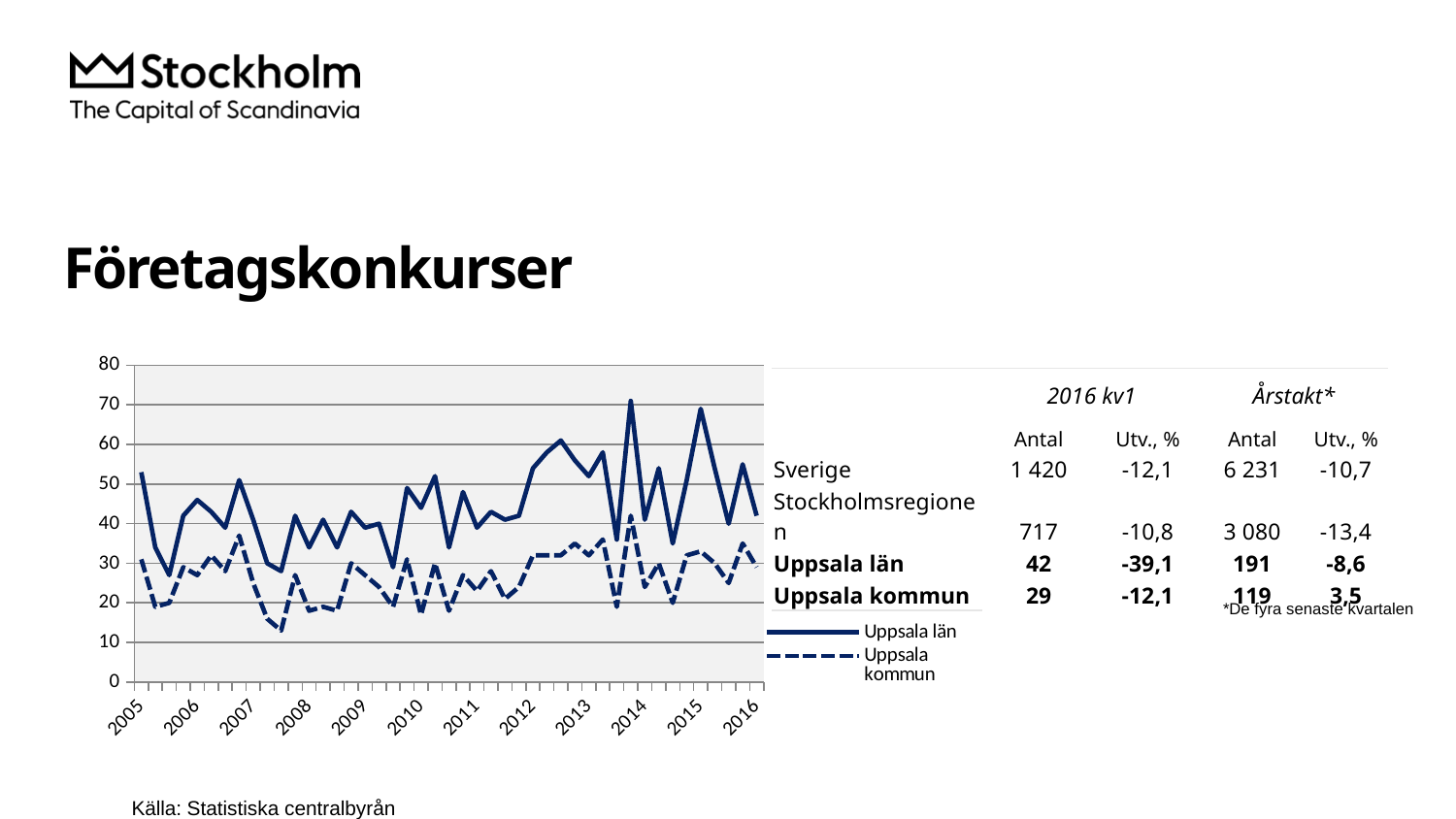
At the 2014 peak, which series has the larger value, Uppsala län or Uppsala kommun? Uppsala län Is the lowest value of Uppsala kommun, around 2007–2008, greater or less than 20? less What is the highest value shown on the chart's vertical axis? 80 Is the value for Uppsala kommun at the start of 2005 greater or less than 20? greater What kind of chart is shown on the slide? line chart Which two series are listed in the chart legend? Uppsala län and Uppsala kommun Which series reaches the highest value on the chart? Uppsala län Which series is drawn with a dashed line? Uppsala kommun How many series does the chart legend list? 2 Is the peak value of Uppsala län around 2014 greater or less than 60? greater How many year labels are shown along the x axis of the chart? 12 From its peak around 2014 to the end of the series in 2016, does the Uppsala län line generally rise or fall? fall